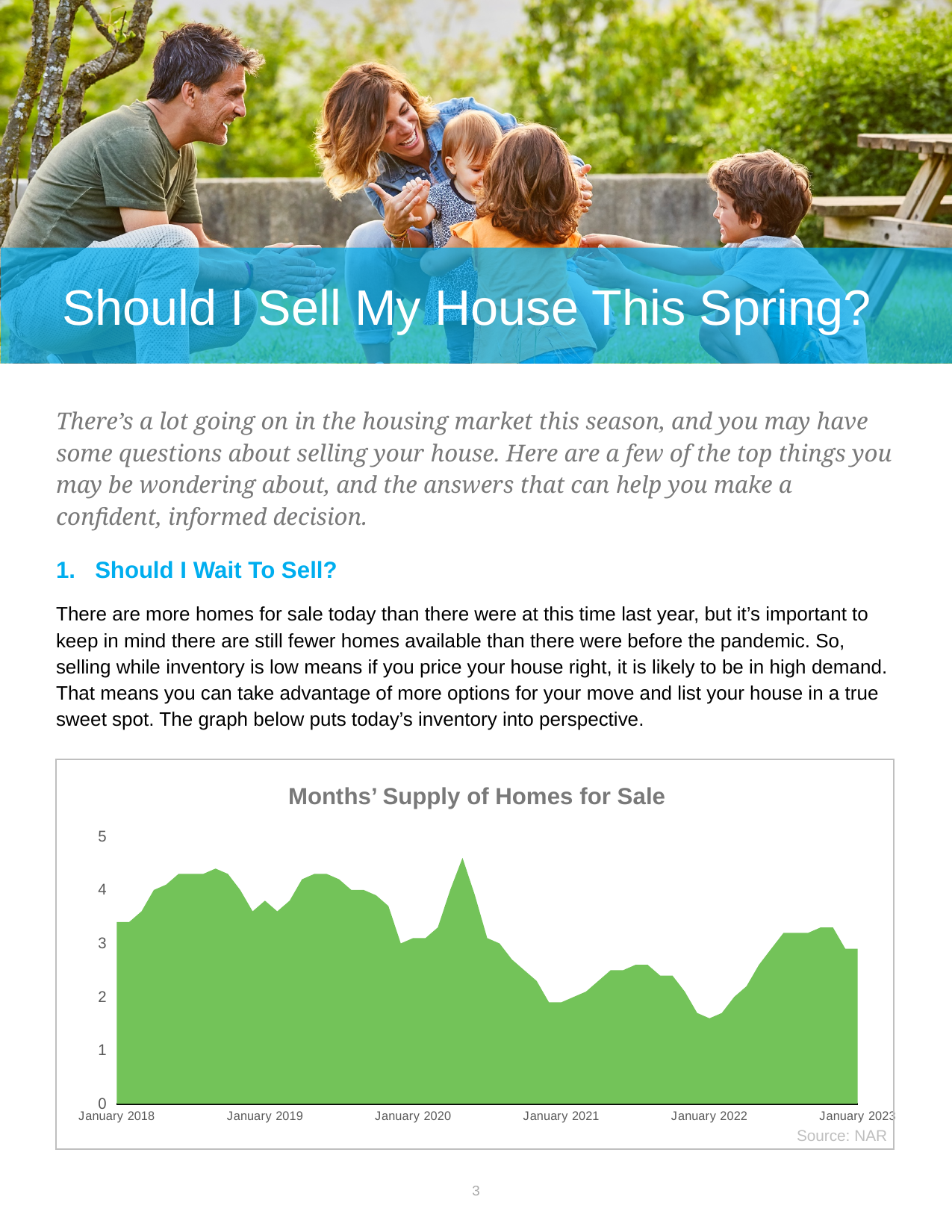
Between which two x-axis labels does the highest peak of the chart occur? January 2020 and January 2021 What is the title of the chart? Months' Supply of Homes for Sale Is the value for January 2018 greater or less than 3? greater Do the values rise or fall from January 2022 to January 2023? rise Is the value for January 2022 larger or smaller than the value for January 2018? smaller Is the highest point on the chart greater or less than 4? greater Is the lowest point on the chart greater or less than 2? less How many year labels are shown on the x axis of the chart? 6 What kind of chart is shown on the slide? Area chart What source is cited for the chart? NAR